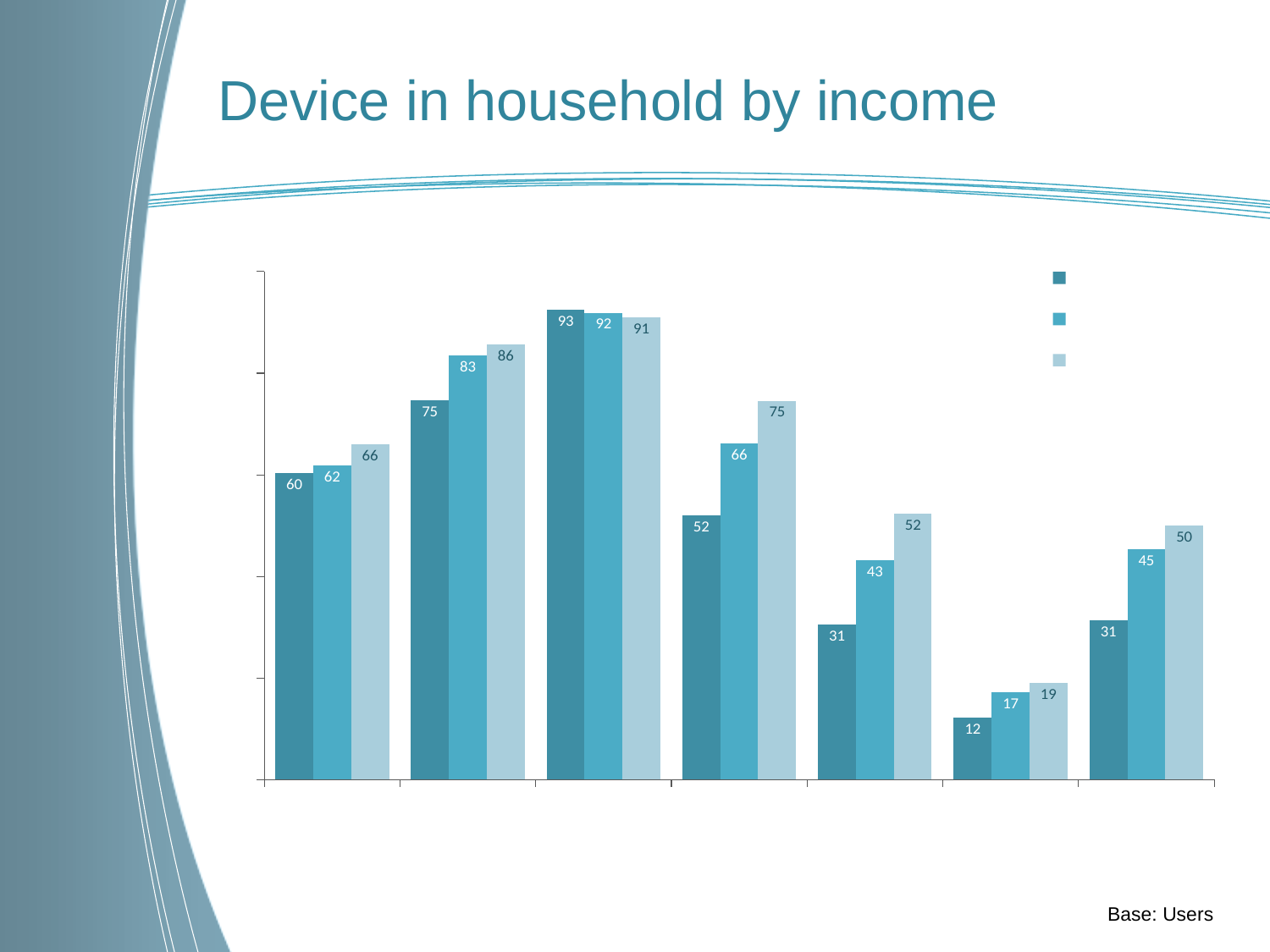
What is the value of the darkest (first) bar in the leftmost group? 60 How many series does the legend list? 3 What is the value of the middle bar in the sixth group from the left? 17 What is the value of the lightest (third) bar in the second group from the left? 86 What is the title of the chart slide? Device in household by income What is the difference between the lightest bar and the darkest bar in the fourth group from the left? 23 What is the difference between the darkest bar in the third group (93) and the darkest bar in the sixth group (12)? 81 Which group of bars has the highest values overall? the third group from the left (93, 92, 91) How many groups of bars are plotted along the x axis? 7 What kind of chart is shown on the slide? bar chart In the rightmost group, which is larger: the darkest bar or the lightest bar? the lightest bar (50) Which group of bars has the lowest values overall? the sixth group from the left (12, 17, 19)